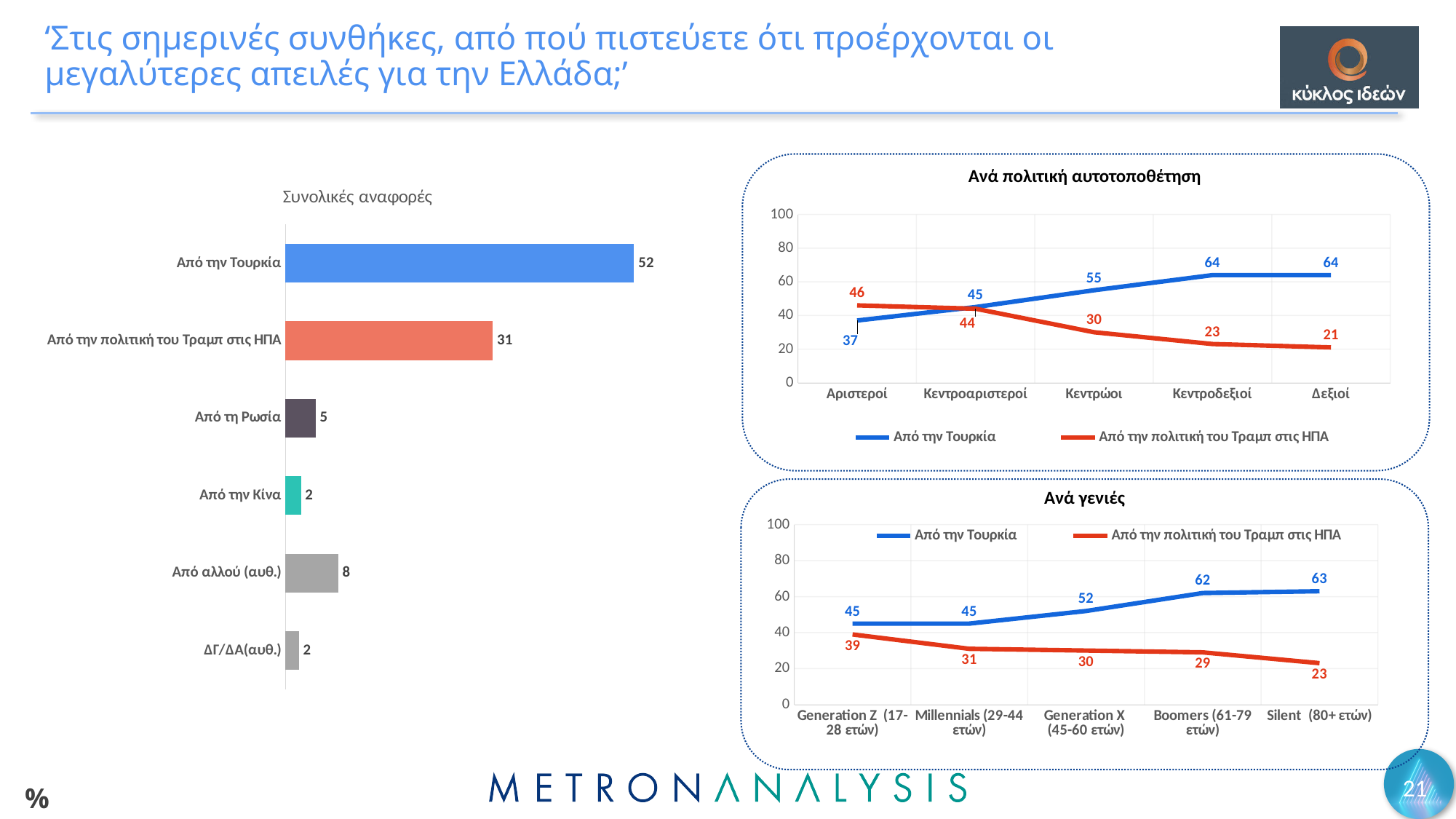
In the 'Ανά γενιές' chart, which is larger for 'Boomers (61-79 ετών)': 'Από την Τουρκία' or 'Από την πολιτική του Τραμπ στις ΗΠΑ'? Από την Τουρκία In the 'Συνολικές αναφορές' chart, what is the value for 'Από την Τουρκία'? 52 In the 'Ανά πολιτική αυτοτοποθέτηση' chart, does the 'Από την Τουρκία' line rise or fall from 'Αριστεροί' to 'Δεξιοί'? Rise What kind of chart is the 'Συνολικές αναφορές' chart? Bar chart In the 'Ανά γενιές' chart, which generation has the highest value for 'Από την Τουρκία'? Silent (80+ ετών) In the 'Συνολικές αναφορές' chart, what is the difference between 'Από την Τουρκία' and 'Από την πολιτική του Τραμπ στις ΗΠΑ'? 21 In the 'Ανά γενιές' chart, what is the value of 'Από την πολιτική του Τραμπ στις ΗΠΑ' for 'Generation Z (17-28 ετών)'? 39 In the 'Ανά πολιτική αυτοτοποθέτηση' chart, which group has the lowest value for 'Από την πολιτική του Τραμπ στις ΗΠΑ'? Δεξιοί In the 'Ανά πολιτική αυτοτοποθέτηση' chart, how many series does the legend list? 2 In the 'Συνολικές αναφορές' chart, which category has the lowest value? Από την Κίνα and ΔΓ/ΔΑ(αυθ.) (both 2) In the 'Ανά πολιτική αυτοτοποθέτηση' chart, what is the value of 'Από την Τουρκία' for 'Κεντρώοι'? 55 In the 'Συνολικές αναφορές' chart, how many categories are shown? 6